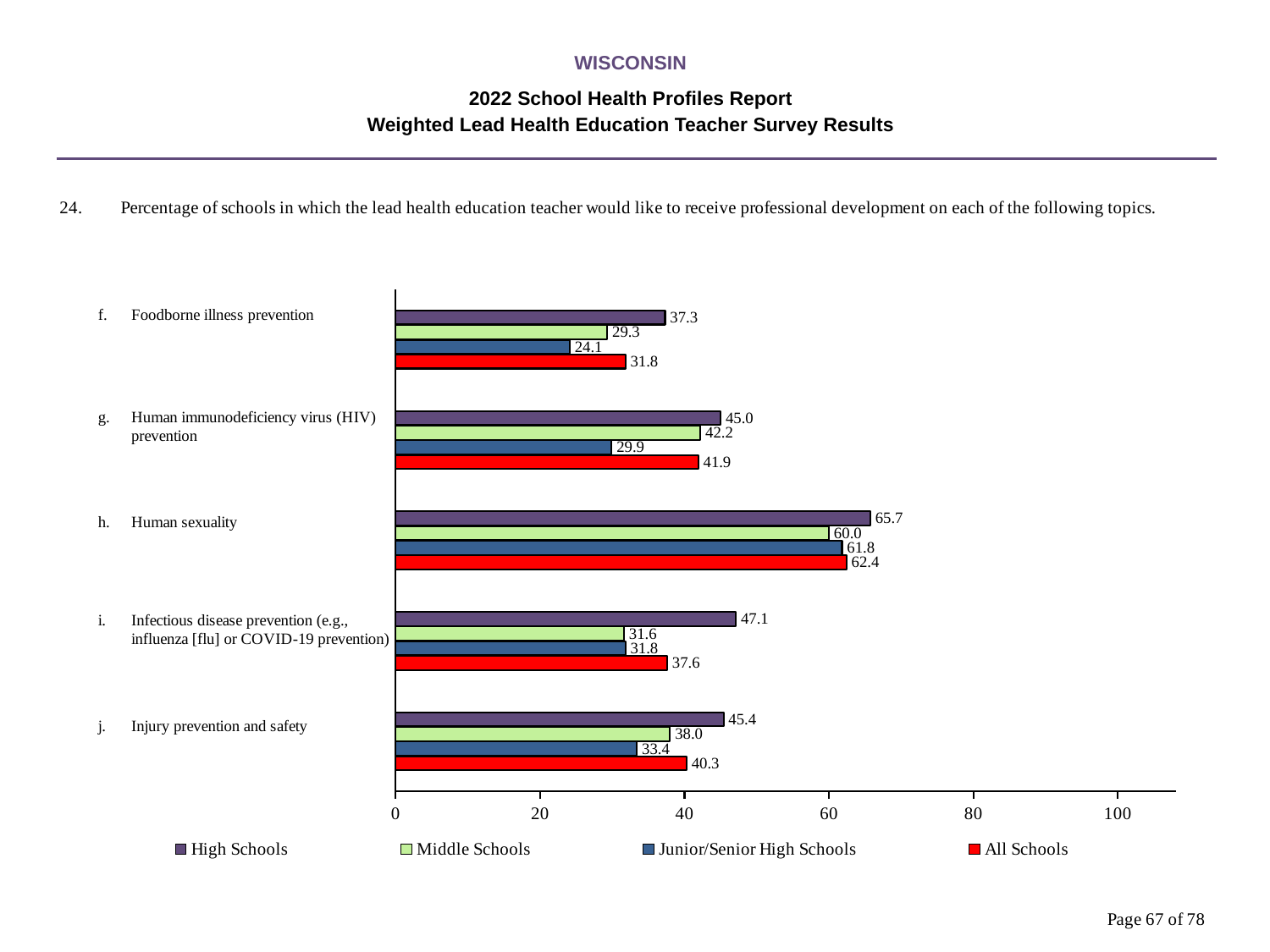
What is the value for Middle Schools for Infectious disease prevention (e.g., influenza [flu] or COVID-19 prevention)? 31.6 What is the value for Junior/Senior High Schools for Foodborne illness prevention? 24.1 What is the value for All Schools for Injury prevention and safety? 40.3 Which topic has the lowest value for High Schools? Foodborne illness prevention What is the difference between the High Schools and Middle Schools values for Infectious disease prevention? 15.5 What kind of chart is shown on the slide? bar chart What is the value for High Schools for Human sexuality? 65.7 Which is larger for Human immunodeficiency virus (HIV) prevention: the High Schools value or the Junior/Senior High Schools value? High Schools Is the All Schools value for Human sexuality greater or less than 60? greater How many topics are shown on the chart? 5 How many series does the legend list? 4 Which topic has the highest value for All Schools? Human sexuality